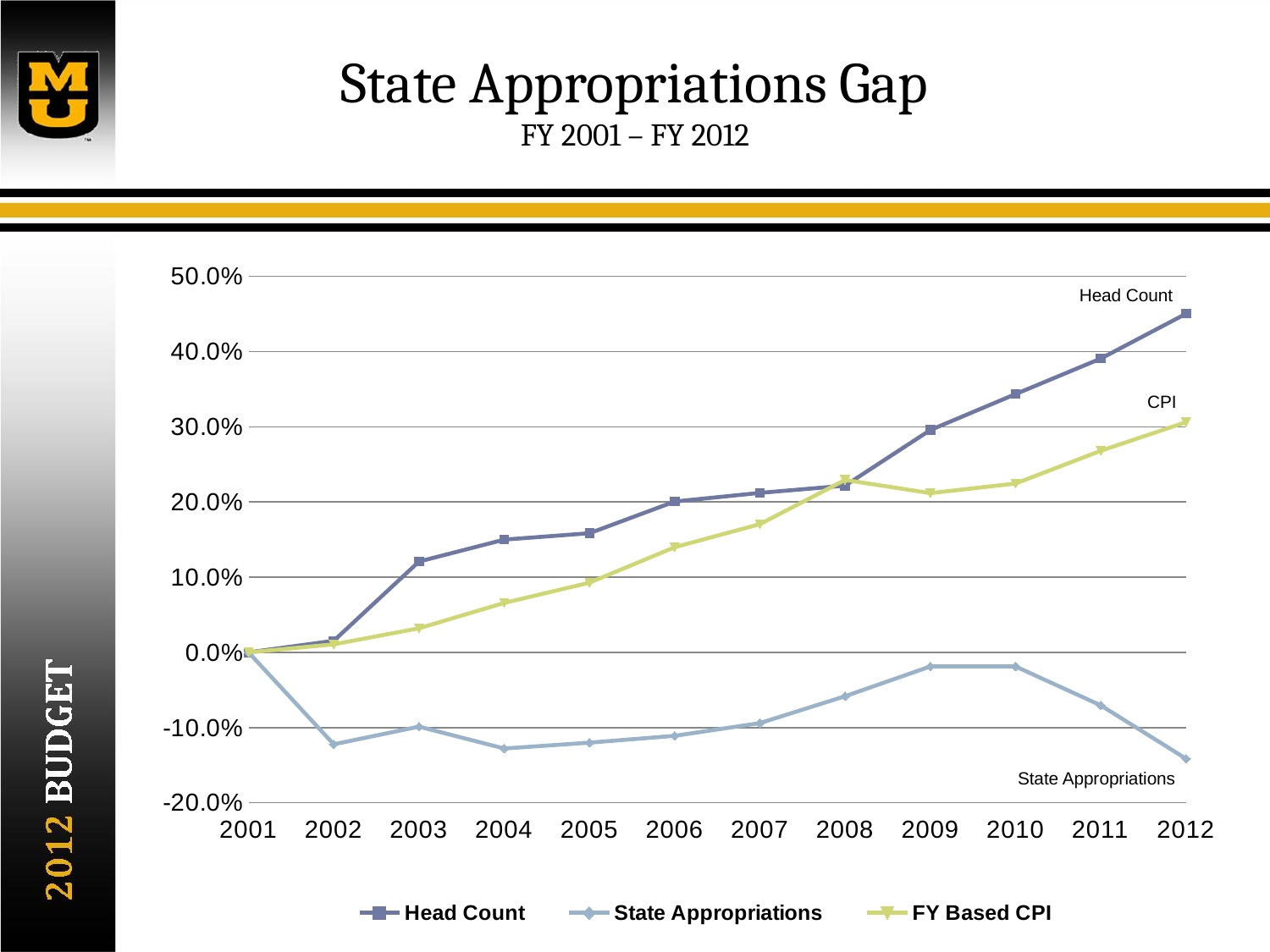
Which series has the highest value in 2012? Head Count How many years are shown on the x axis? 12 Is the Head Count value for 2012 greater or less than 40.0%? greater Is the State Appropriations value for 2009 greater or less than -10.0%? greater Is the FY Based CPI value for 2008 greater or less than 20.0%? greater What kind of chart is shown on the slide? Line chart In 2012, which series has the higher value, Head Count or FY Based CPI? Head Count What is the title of the chart slide? State Appropriations Gap Does the Head Count series generally rise or fall from 2001 to 2012? Rise How many series does the legend list? 3 What is the Head Count value in 2001? 0.0%